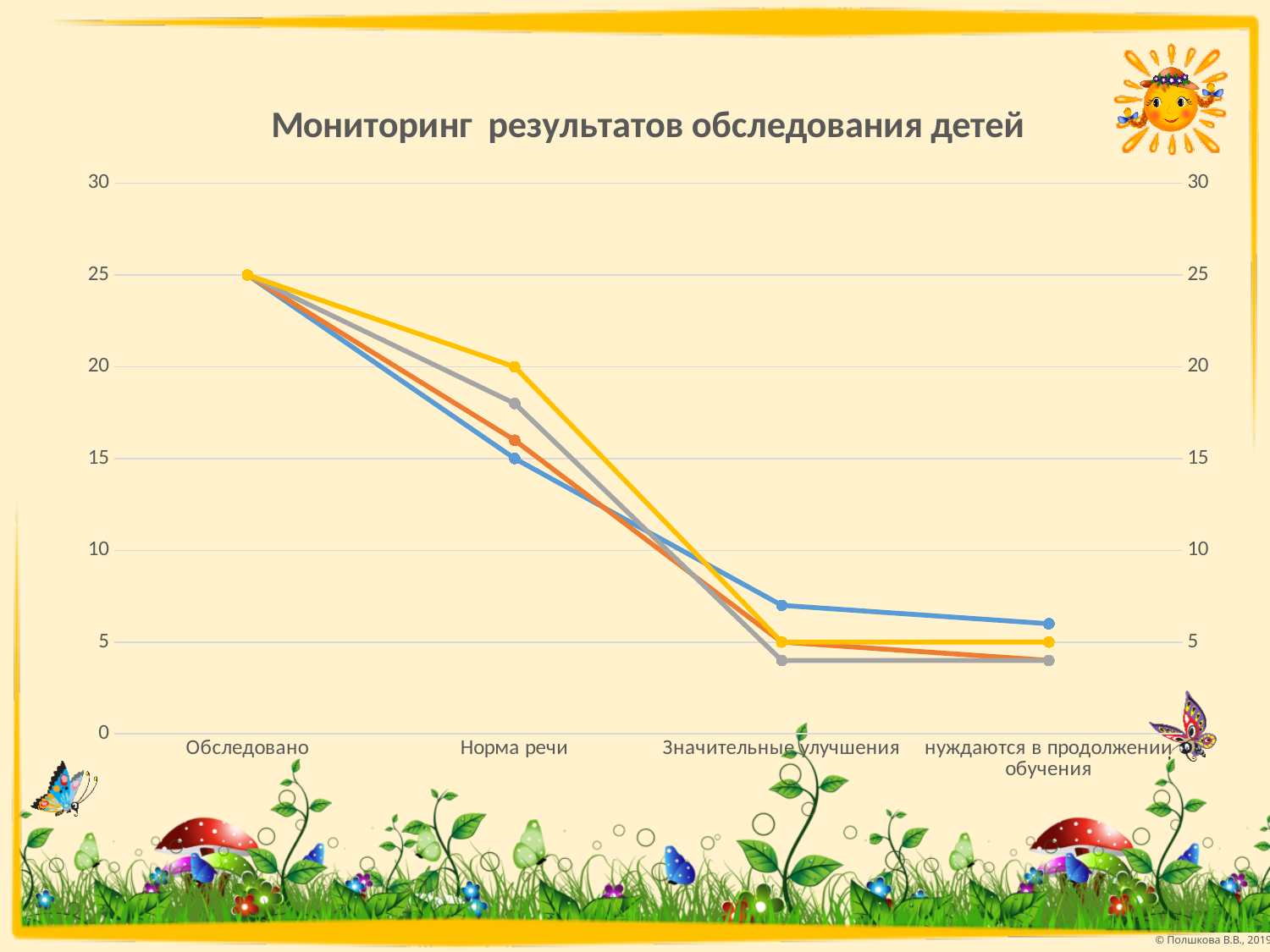
By how much does the yellow line drop from 'Обследовано' to 'Норма речи'? 5 Is the value of the gray line at 'Норма речи' greater or less than 15? greater What is the title of the chart? Мониторинг результатов обследования детей What kind of chart is shown on the slide? line chart How many categories are shown on the x axis of the chart? 4 What is the value of the yellow line at 'Норма речи'? 20 Is the value of the blue line at 'Значительные улучшения' greater or less than 5? greater Which line has the highest value at 'Норма речи'? the yellow line What is the value of the yellow line at 'Значительные улучшения'? 5 What is the value of the blue line at 'Норма речи'? 15 What is the value of the lines at the category 'Обследовано'? 25 Do the values of the lines rise or fall from left to right along the x axis? fall